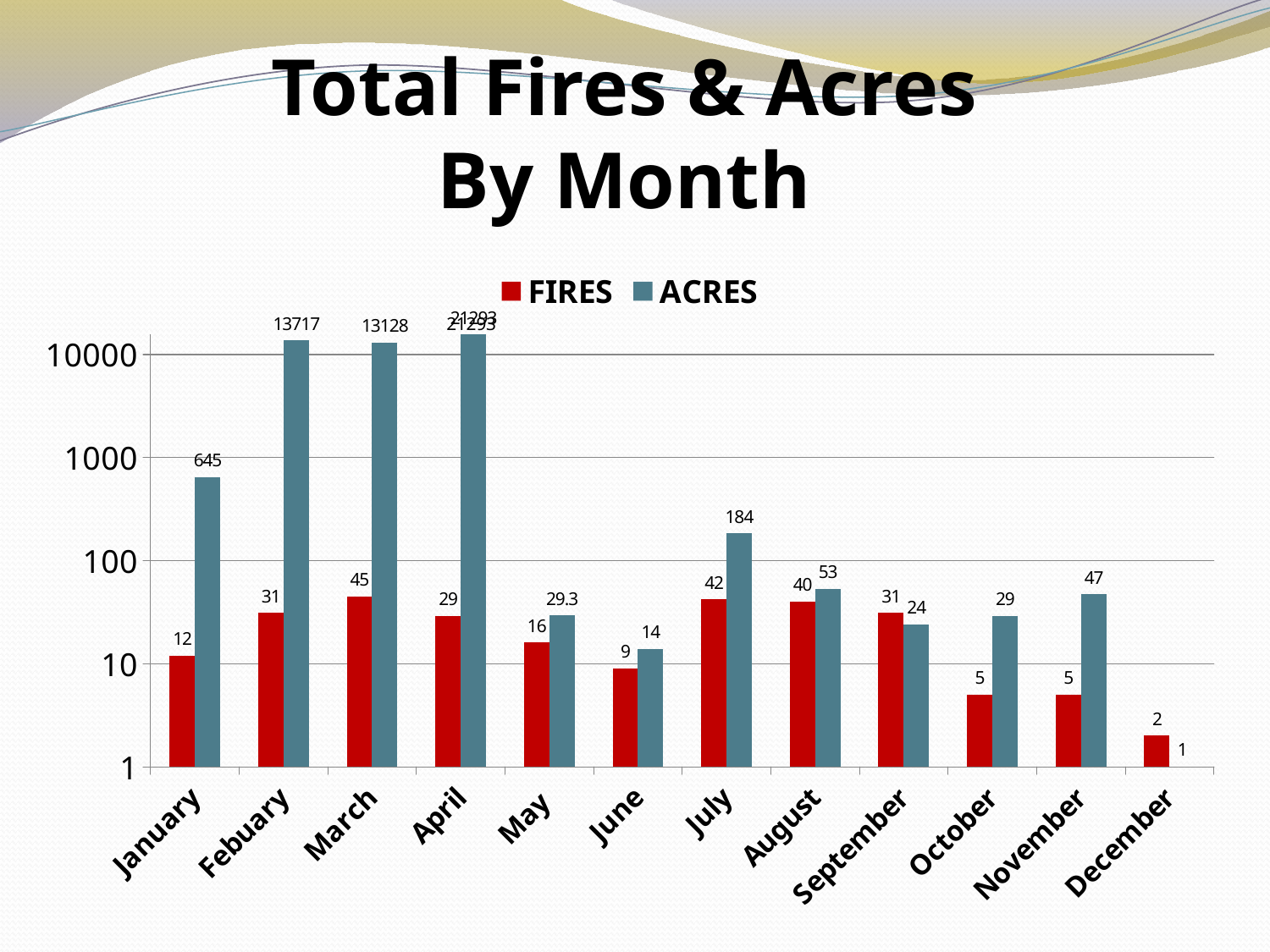
What is the ACRES value for May? 29.3 Is the ACRES value for January greater or less than 100? greater Which month has the highest FIRES value? March Which is larger, the FIRES value for July or the FIRES value for August? July What kind of chart is shown on the slide? bar chart How many series does the legend list? 2 What is the difference between the ACRES values for February and March? 589 What is the ACRES value for February? 13717 How many months are shown on the x axis? 12 What is the FIRES value for March? 45 What colour are the FIRES bars? red Which month has the lowest ACRES value? December